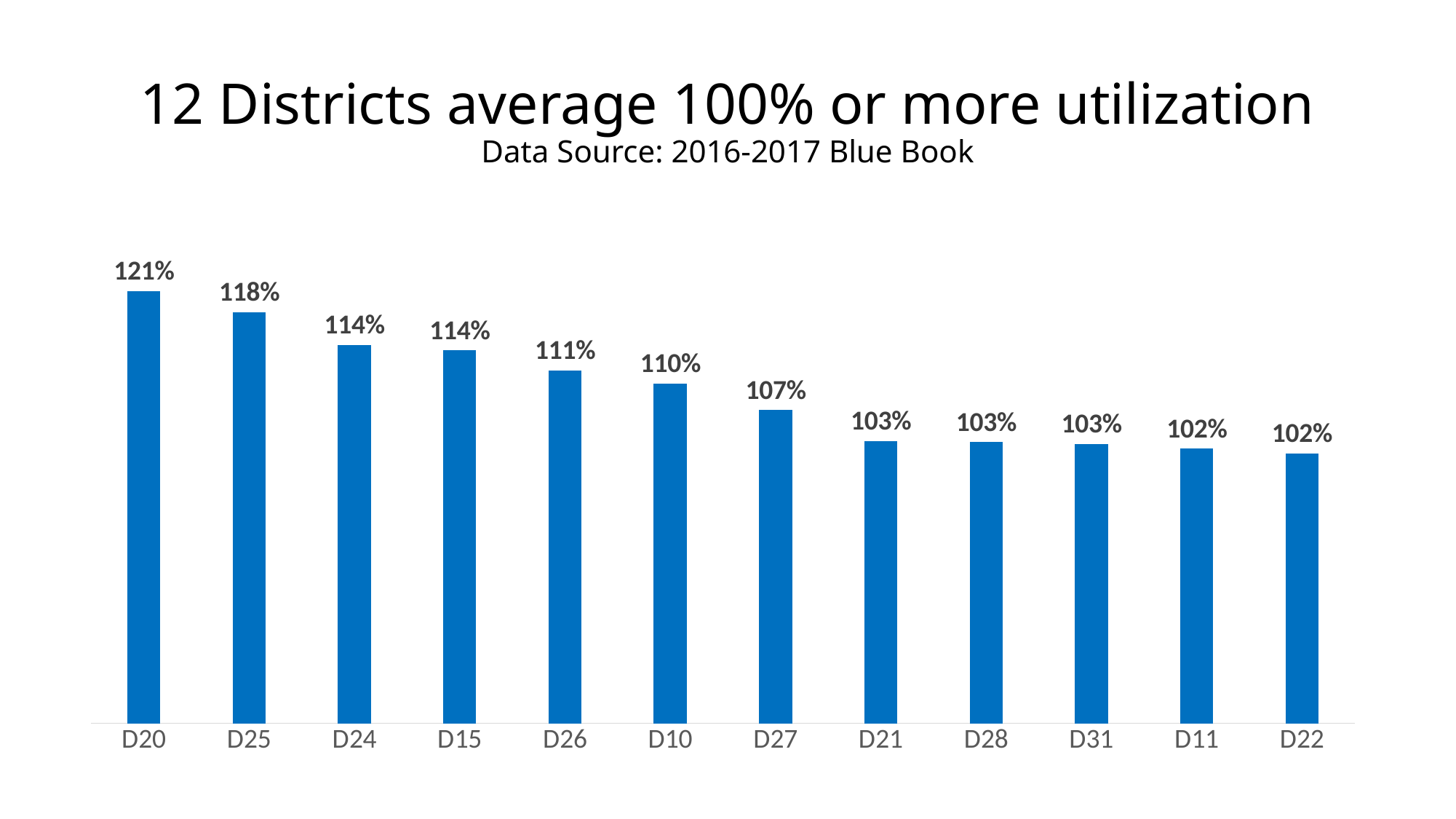
What is the utilization value for D20? 121% Which district has the highest utilization? D20 What is the difference between the utilization of D26 and D22? 9% What is the difference between the utilization of D20 and D25? 3% How many districts are shown in the chart? 12 What is the utilization value for D10? 110% What is the utilization value for D31? 103% What is the utilization value for D27? 107% Do the values rise or fall from left to right along the x axis? Fall Which has a higher utilization, D24 or D27? D24 Which has a higher utilization, D21 or D25? D25 What kind of chart is shown on the slide? Bar chart